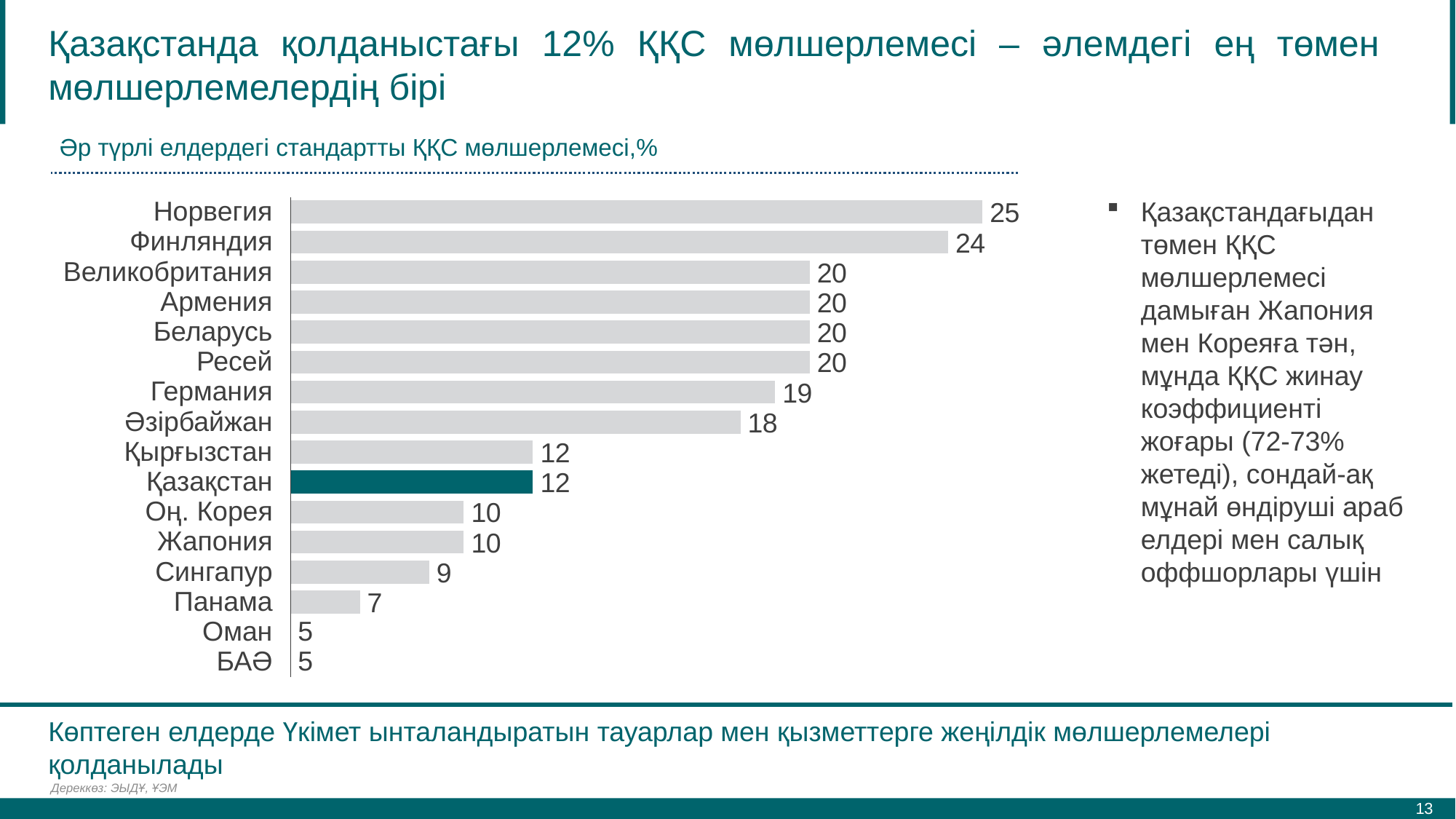
What is the difference between the values for Финляндия and Жапония? 14 Which has a higher value, Әзірбайжан or Сингапур? Әзірбайжан What value is shown for Қазақстан? 12 Which country's bar is highlighted in a different (dark teal) colour? Қазақстан What is the difference between the values for Норвегия and Қазақстан? 13 What value is shown for Германия? 19 What is the lowest value shown in the chart? 5 Which country has the highest VAT rate in the chart? Норвегия What kind of chart is shown on the slide? Bar chart How many countries are shown in the chart? 16 What is the VAT rate shown for Норвегия? 25 What value is shown for Панама? 7